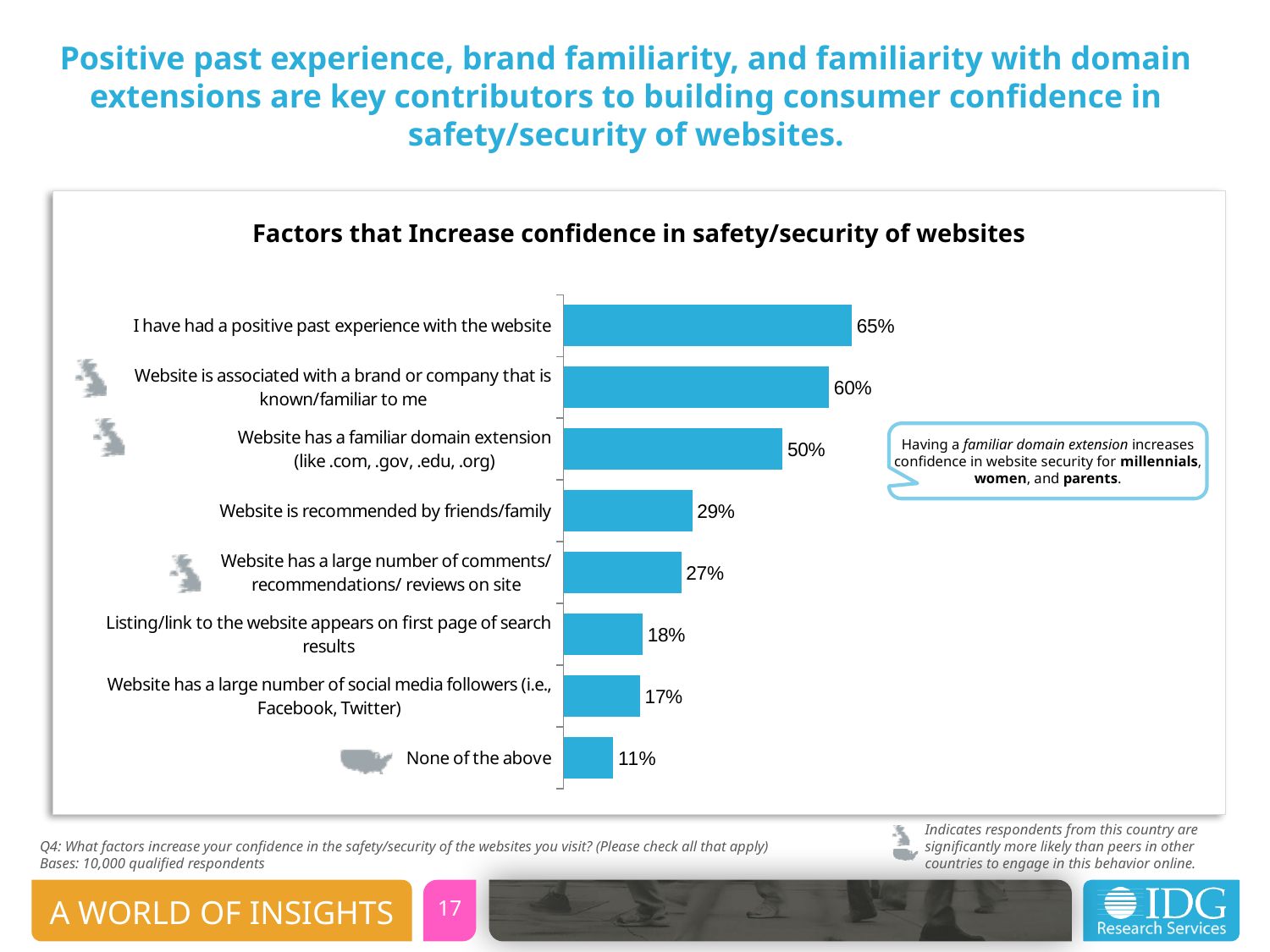
What is the difference between the percentage for a positive past experience (65%) and a familiar domain extension (50%)? 15% What is the title of the chart? Factors that Increase confidence in safety/security of websites What is the value for 'Website has a familiar domain extension (like .com, .gov, .edu, .org)'? 50% Which category has the lowest percentage in the chart? None of the above What is the value for 'None of the above'? 11% Which factor has the highest percentage in the chart? I have had a positive past experience with the website What percentage selected 'Website is recommended by friends/family'? 29% What type of chart is shown on the slide? Bar chart Which is larger: the value for 'Website is recommended by friends/family' or 'Website has a large number of comments/recommendations/reviews on site'? Website is recommended by friends/family What percentage of respondents said a positive past experience with the website increases their confidence? 65% How many categories are shown in the chart? 8 What is the difference between 'Listing/link to the website appears on first page of search results' and 'Website has a large number of social media followers'? 1%